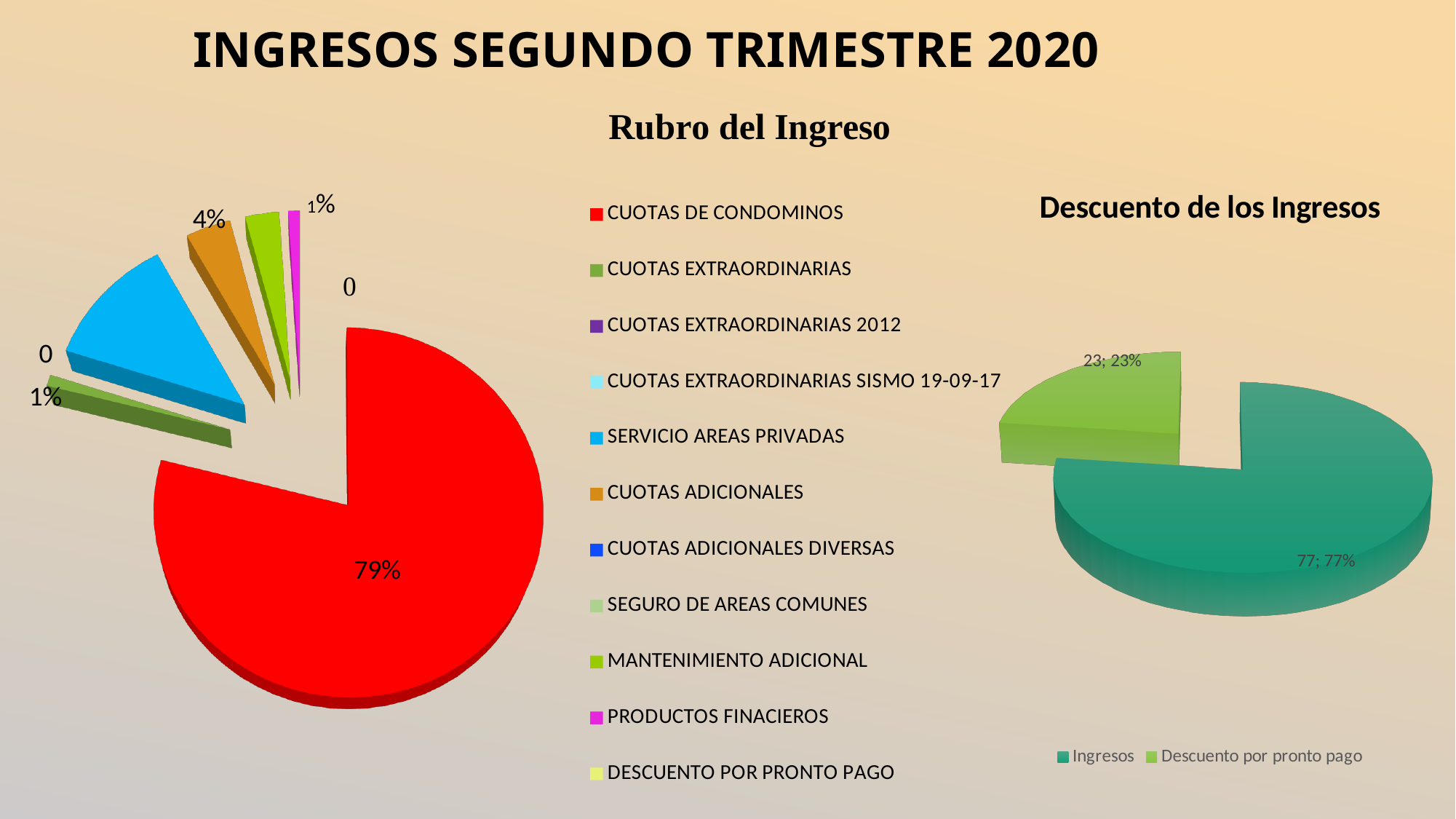
In the 'Rubro del Ingreso' chart, what share does CUOTAS DE CONDOMINOS have? 79% In the 'Rubro del Ingreso' chart, what share does CUOTAS ADICIONALES have? 4% How many entries does the legend of the 'Rubro del Ingreso' chart list? 11 In the 'Descuento de los Ingresos' chart, what is the difference between the values for Ingresos and Descuento por pronto pago? 54 In the 'Descuento de los Ingresos' chart, what share does Descuento por pronto pago have? 23% What type of chart is the 'Descuento de los Ingresos' chart? pie chart In the 'Descuento de los Ingresos' chart, what is the value for Ingresos? 77 In the 'Rubro del Ingreso' chart, which category has the largest slice? CUOTAS DE CONDOMINOS In the 'Rubro del Ingreso' chart, what colour is the CUOTAS DE CONDOMINOS slice? red How many entries does the legend of the 'Descuento de los Ingresos' chart list? 2 In the 'Descuento de los Ingresos' chart, which is larger, Ingresos or Descuento por pronto pago? Ingresos What type of chart is the 'Rubro del Ingreso' chart? pie chart